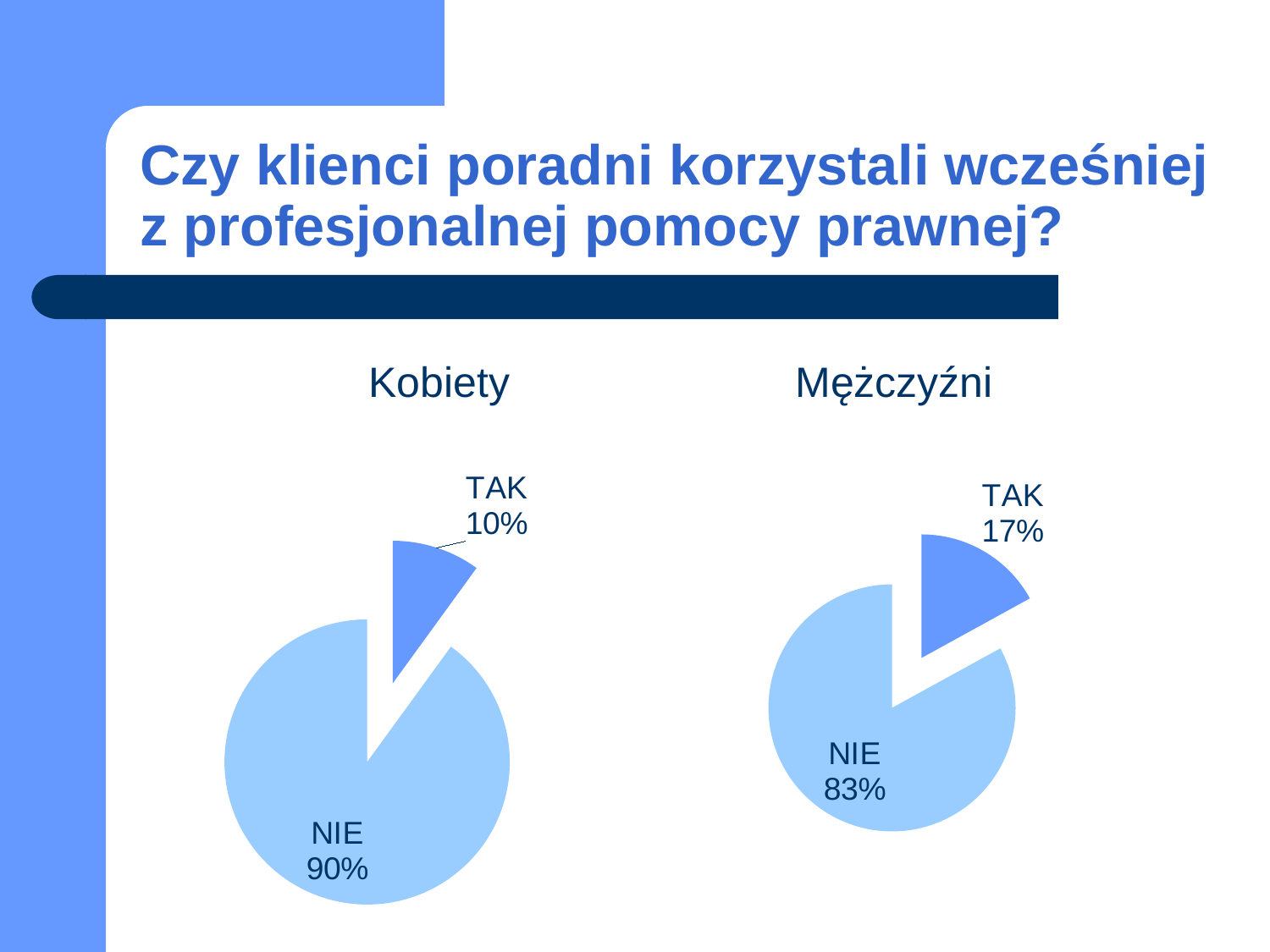
In the Kobiety chart, what share of the pie is TAK? 10% In the Kobiety chart, what share of the pie is NIE? 90% In the Mężczyźni chart, which slice is the smallest? TAK In the Mężczyźni chart, what share of the pie is TAK? 17% What is the difference between the NIE and TAK shares in the Mężczyźni chart? 66% Which is larger: the TAK share in the Kobiety chart or the TAK share in the Mężczyźni chart? Mężczyźni How many slices does the Mężczyźni chart have? 2 What is the difference between the NIE and TAK shares in the Kobiety chart? 80% In the Kobiety chart, which slice is the largest? NIE What is the title of the chart on the right? Mężczyźni What kind of chart is the Kobiety chart? Pie chart